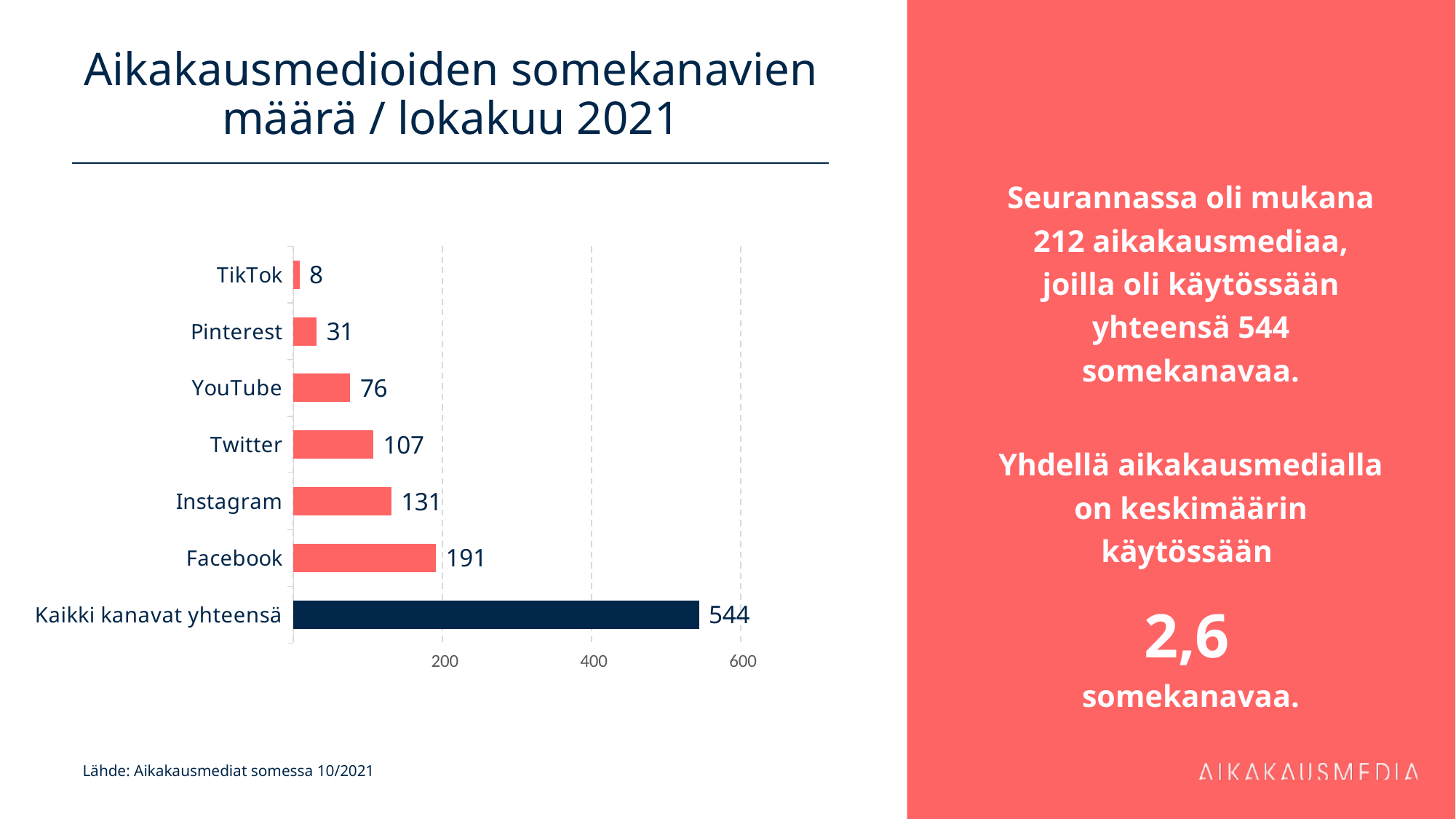
What is the value for Kaikki kanavat yhteensä? 544 How many categories are shown in the chart? 7 Which category has the lowest value? TikTok Which is larger, the value for Twitter or the value for YouTube? Twitter What is the value for Instagram? 131 What is the value for Facebook? 191 Which individual channel (excluding the total bar) has the highest value? Facebook What is the title of the chart? Aikakausmedioiden somekanavien määrä / lokakuu 2021 Is the value for Facebook greater or less than 200? less What is the difference between the values for Facebook and Instagram? 60 What kind of chart is shown on the slide? bar chart What is the value for TikTok? 8